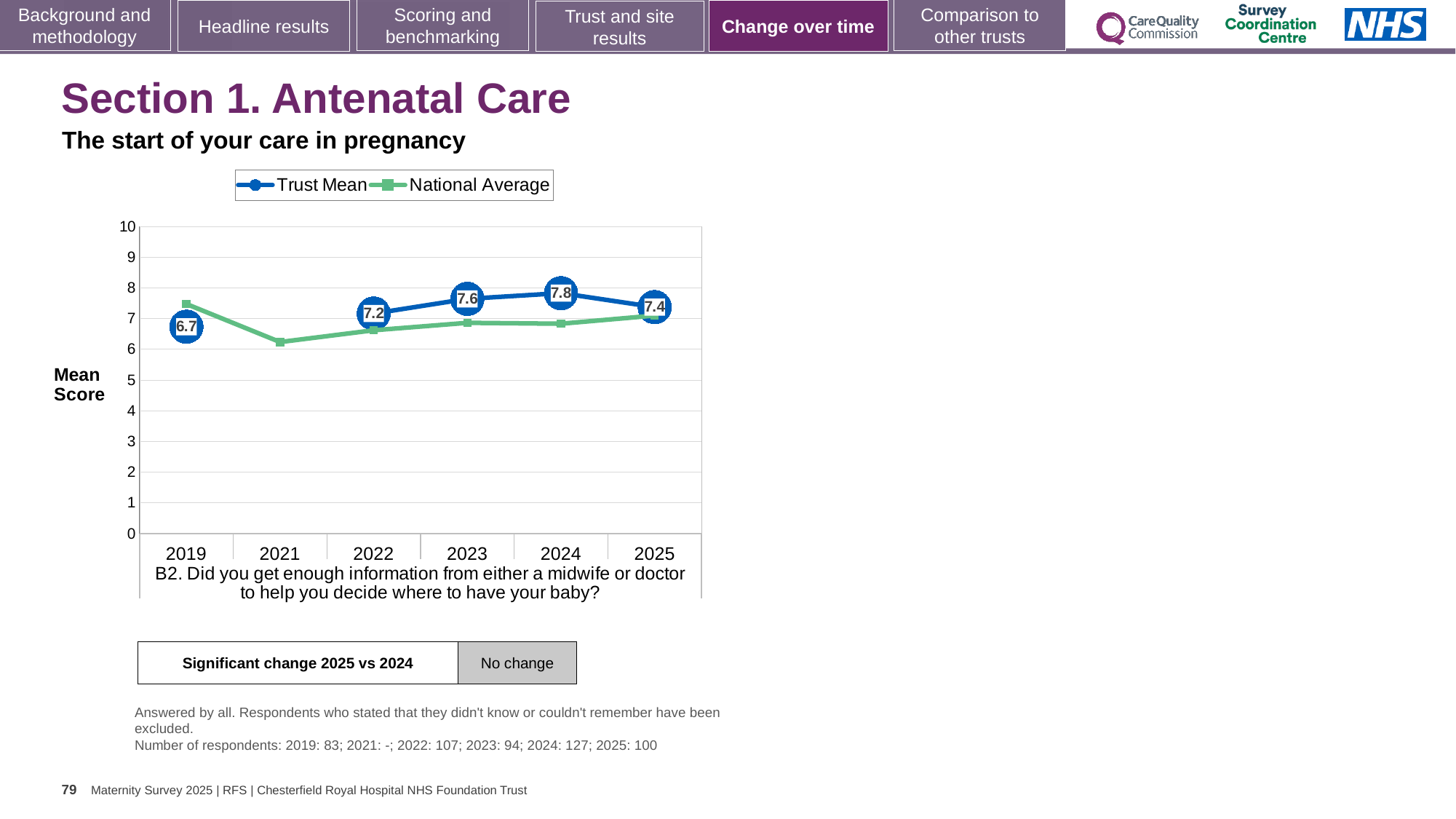
How many years are shown on the x axis of the chart? 6 What is the Trust Mean score for 2019? 6.7 What kind of chart is shown on the slide? line chart Is the National Average value for 2021 greater or less than 7? less What is the Trust Mean score for 2024? 7.8 What is the difference between the Trust Mean scores for 2024 and 2025? 0.4 Which year has the larger Trust Mean score, 2022 or 2023? 2023 How many series does the chart legend list? 2 In which year is the Trust Mean score highest? 2024 In which year is the Trust Mean score lowest? 2019 What is the Trust Mean score for 2025? 7.4 Does the Trust Mean score rise or fall from 2022 to 2024? rise